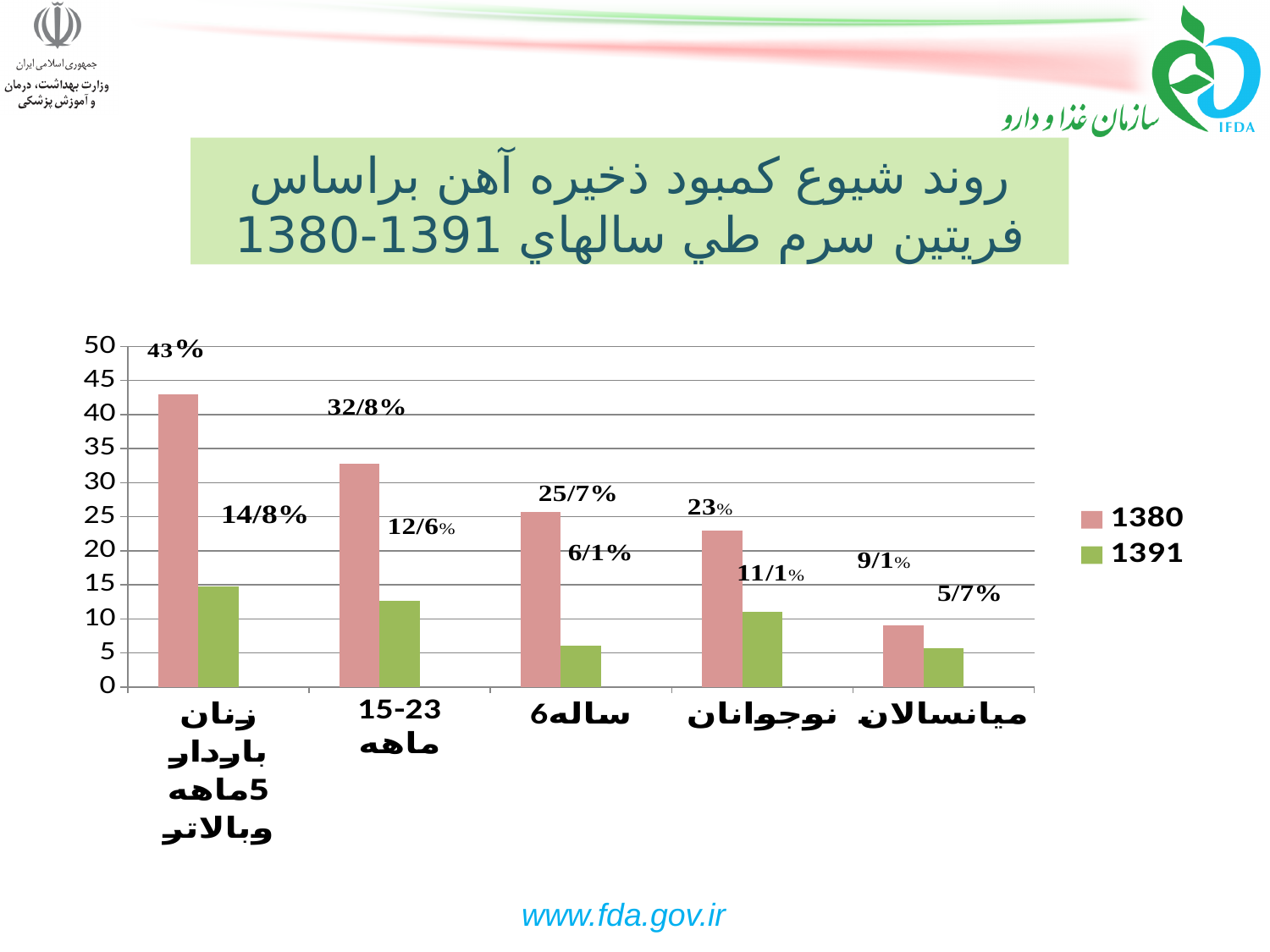
What is the 1380 value for the category 6 ساله? 25/7% Which category has the highest 1380 value? زنان باردار 5ماهه وبالاتر Do the 1380 values rise or fall moving from left to right along the x axis? fall Which is larger: the 1391 value for 6 ساله or the 1391 value for نوجوانان? نوجوانان What is the 1391 value for the category نوجوانان? 11/1% How many categories are shown on the x axis? 5 What type of chart is shown on the slide? bar chart Which category has the lowest 1391 value? میانسالان What is the 1380 value for the category زنان باردار 5ماهه وبالاتر? 43% What is the 1380 value for the category میانسالان? 9/1% What is the 1391 value for the category 15-23 ماهه? 12/6% How many series does the legend list? 2